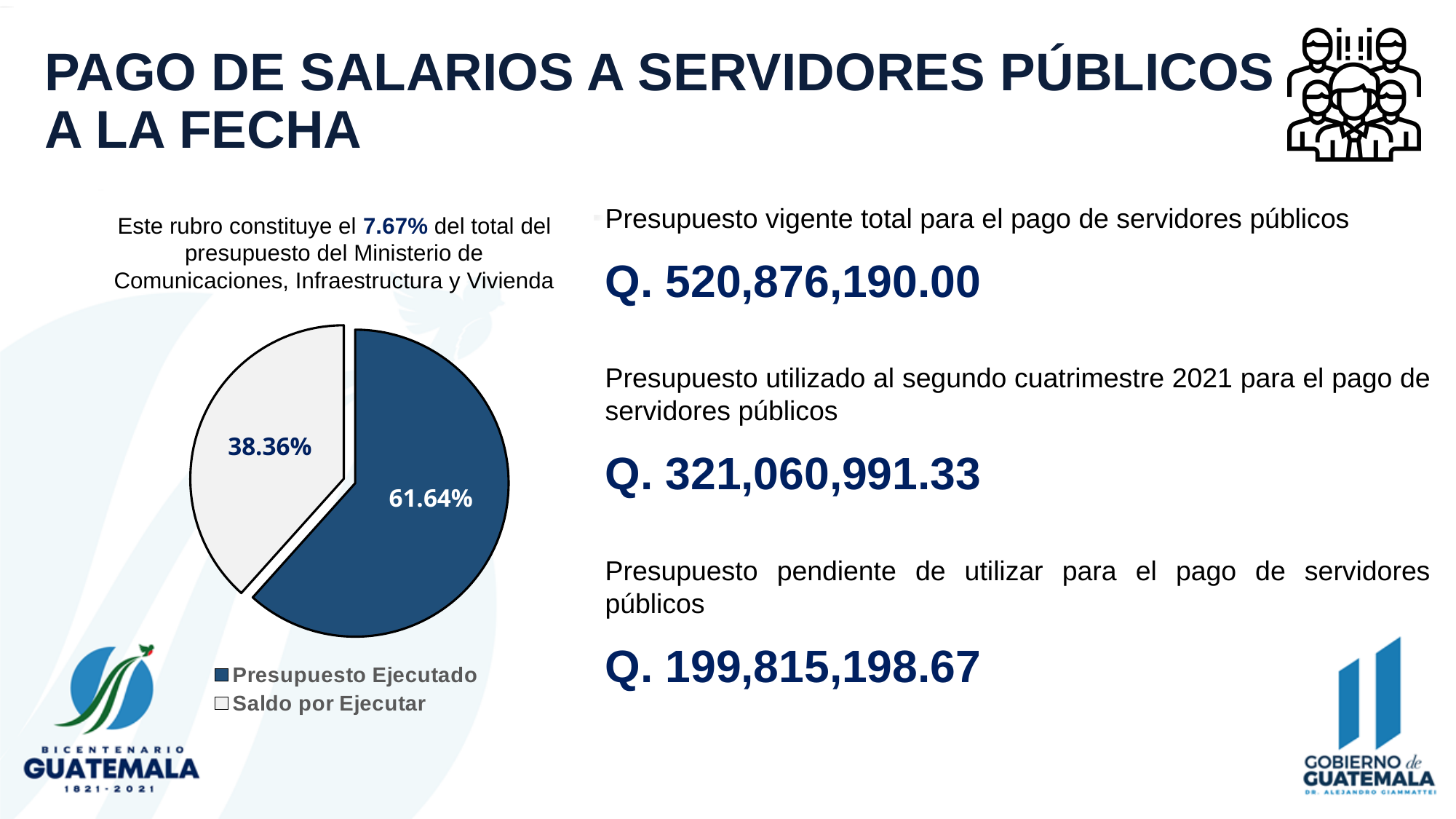
How many slices does the pie chart have? 2 Which slice of the pie chart is the smallest? Saldo por Ejecutar Which slice of the pie chart is the largest? Presupuesto Ejecutado How many entries does the legend list? 2 Which is larger, Presupuesto Ejecutado or Saldo por Ejecutar? Presupuesto Ejecutado What kind of chart is shown on the slide? pie chart What is the difference in percentage points between Presupuesto Ejecutado and Saldo por Ejecutar? 23.28 What percentage does the Saldo por Ejecutar slice show? 38.36% What share of the pie does Saldo por Ejecutar represent? 38.36% Which legend entry is shown in dark blue? Presupuesto Ejecutado What percentage does the Presupuesto Ejecutado slice show? 61.64% Which legend entry is shown in light grey/white? Saldo por Ejecutar